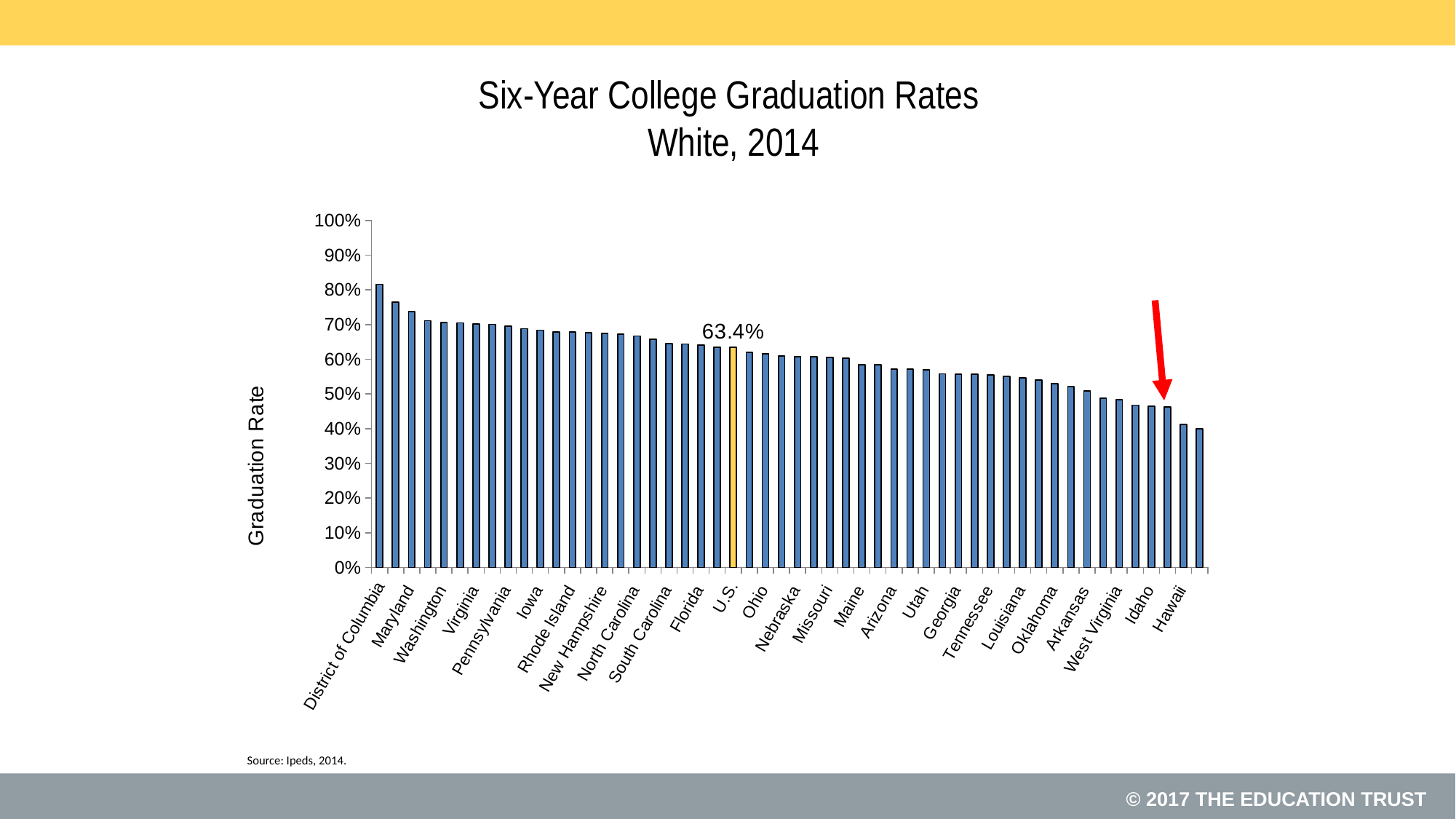
Is the value for Idaho greater or less than 50%? less Do the values rise or fall moving from left to right along the x axis? fall What is the six-year college graduation rate shown for the U.S.? 63.4% Is the value for Florida greater or less than 60%? greater Which has a higher graduation rate, Virginia or Ohio? Virginia Which bar is highlighted in yellow on the chart? U.S. Which has a higher graduation rate, Maryland or Hawaii? Maryland Is the value for Utah greater or less than 60%? less What kind of chart is shown on the slide? bar chart Which category has the highest graduation rate on the chart? District of Columbia